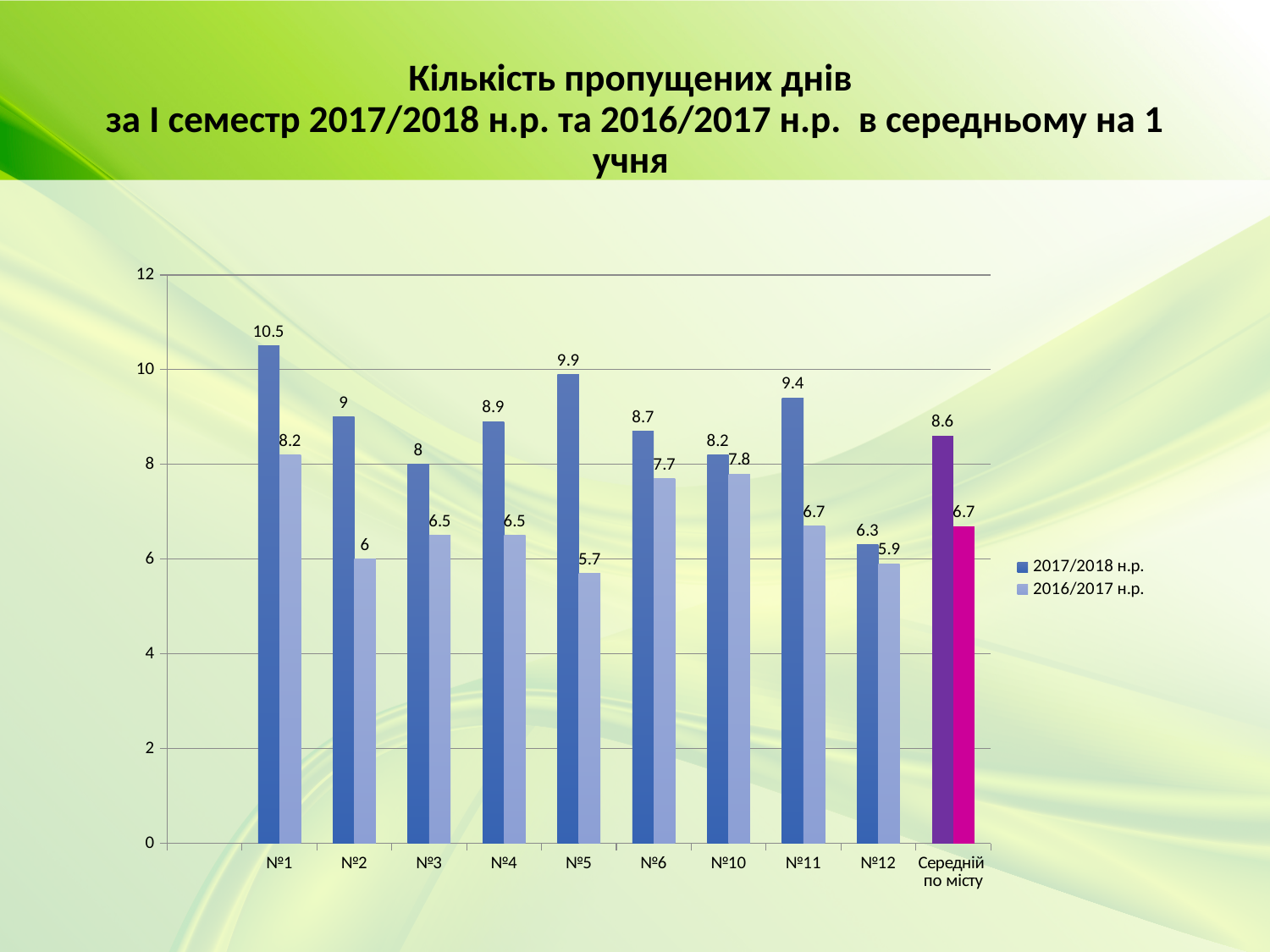
Which category has the lowest value in the 2016/2017 н.р. series? №5 What is the value for №1 in the 2017/2018 н.р. series? 10.5 What is the value for №12 in the 2016/2017 н.р. series? 5.9 What is the value for Середній по місту in the 2017/2018 н.р. series? 8.6 Which category has the highest value in the 2017/2018 н.р. series? №1 How many series does the legend list? 2 What is the difference between the 2017/2018 н.р. values for №1 and №12? 4.2 What kind of chart is shown on the slide? Bar chart Which is larger for №10: the 2017/2018 н.р. value or the 2016/2017 н.р. value? 2017/2018 н.р. How many categories are shown on the x axis? 10 What is the value for №5 in the 2016/2017 н.р. series? 5.7 What is the difference between the 2017/2018 н.р. and 2016/2017 н.р. values for №5? 4.2